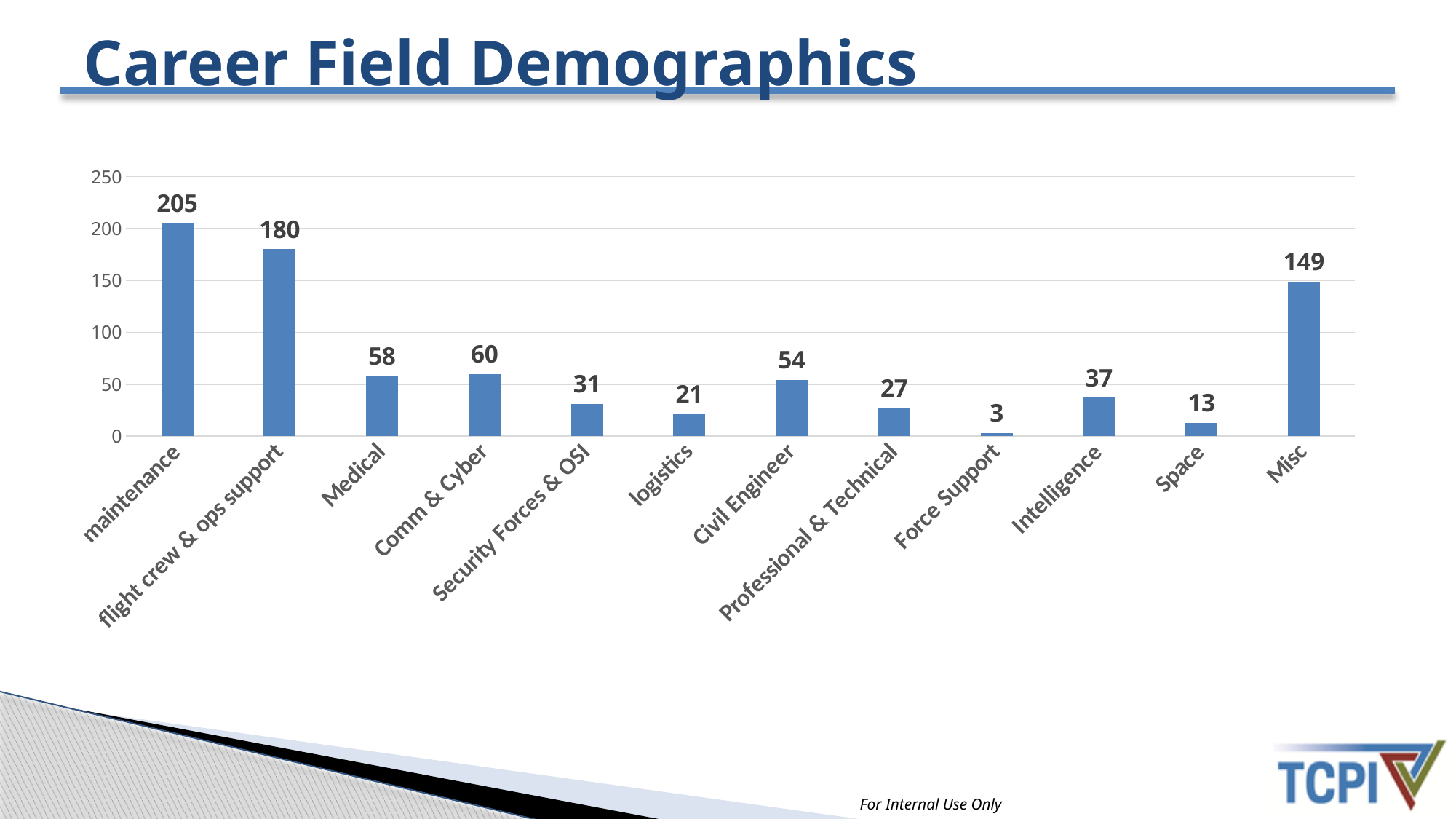
Which is larger, Medical or Civil Engineer? Medical What is the value for maintenance? 205 Is the value for Misc greater or less than 100? greater How many career field categories are shown in the chart? 12 Which career field has the highest value? maintenance What is the title of the slide? Career Field Demographics What kind of chart is shown on the slide? bar chart What is the value for Comm & Cyber? 60 What is the difference between Intelligence and Space? 24 What is the value for Misc? 149 Which career field has the lowest value? Force Support What is the difference between maintenance and flight crew & ops support? 25